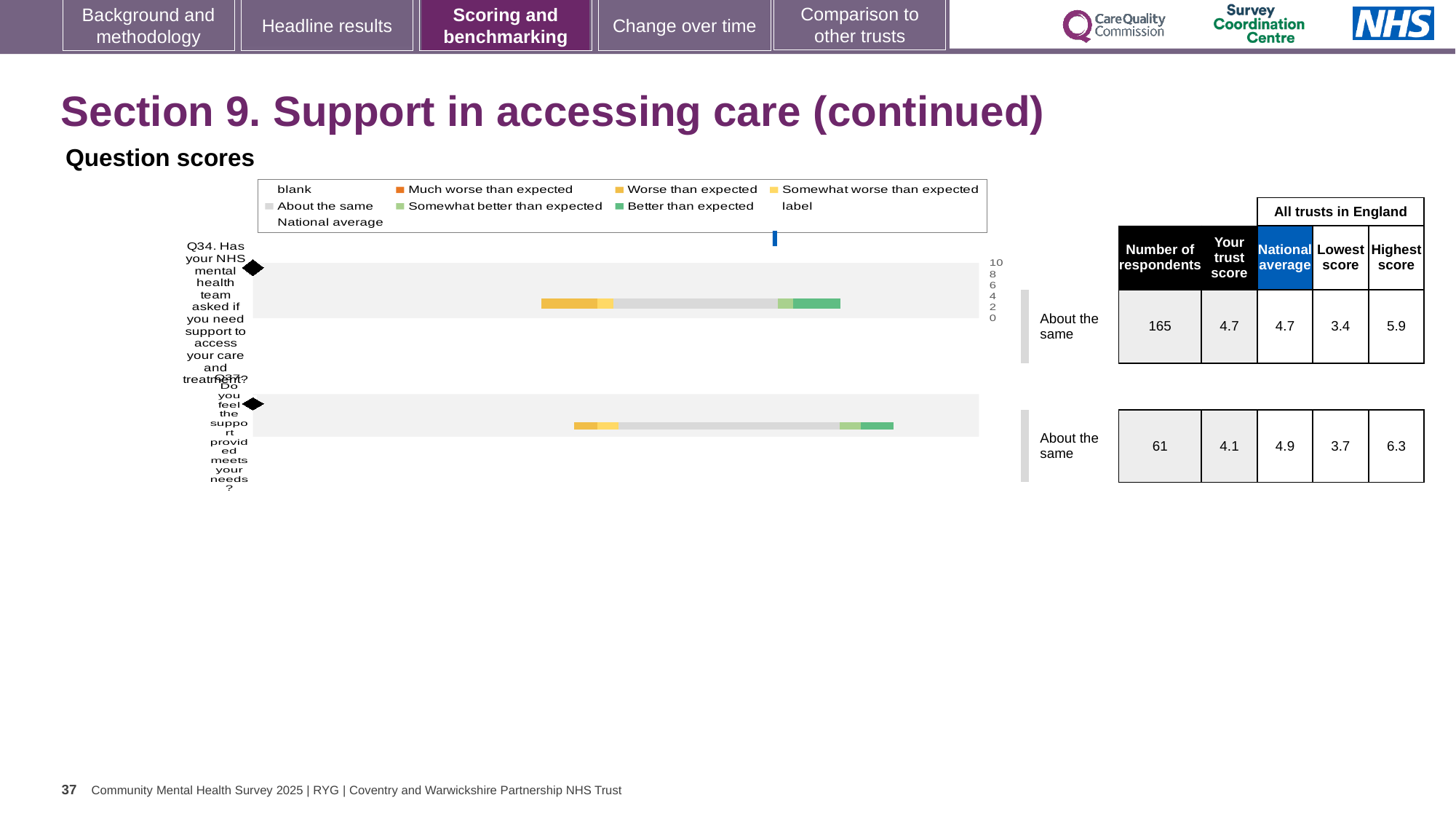
What is the heading above the chart? Question scores In the table beside the chart, what is the national average for Q37? 4.9 In the table beside the chart, what is the highest score for Q34? 5.9 What kind of chart is shown under 'Question scores'? bar chart In the table beside the chart, what is the number of respondents for Q34? 165 In the table, what is the difference between the national average and the trust score for Q37? 0.8 What benchmark category is shown next to the bar for Q37? About the same In the table beside the chart, what is the trust score for Q37? 4.1 What benchmark category is shown next to the bar for Q34? About the same Which legend entry is shown in dark green? Better than expected How many questions (bars) are plotted in the 'Question scores' chart? 2 Which question has the higher trust score in the table, Q34 or Q37? Q34